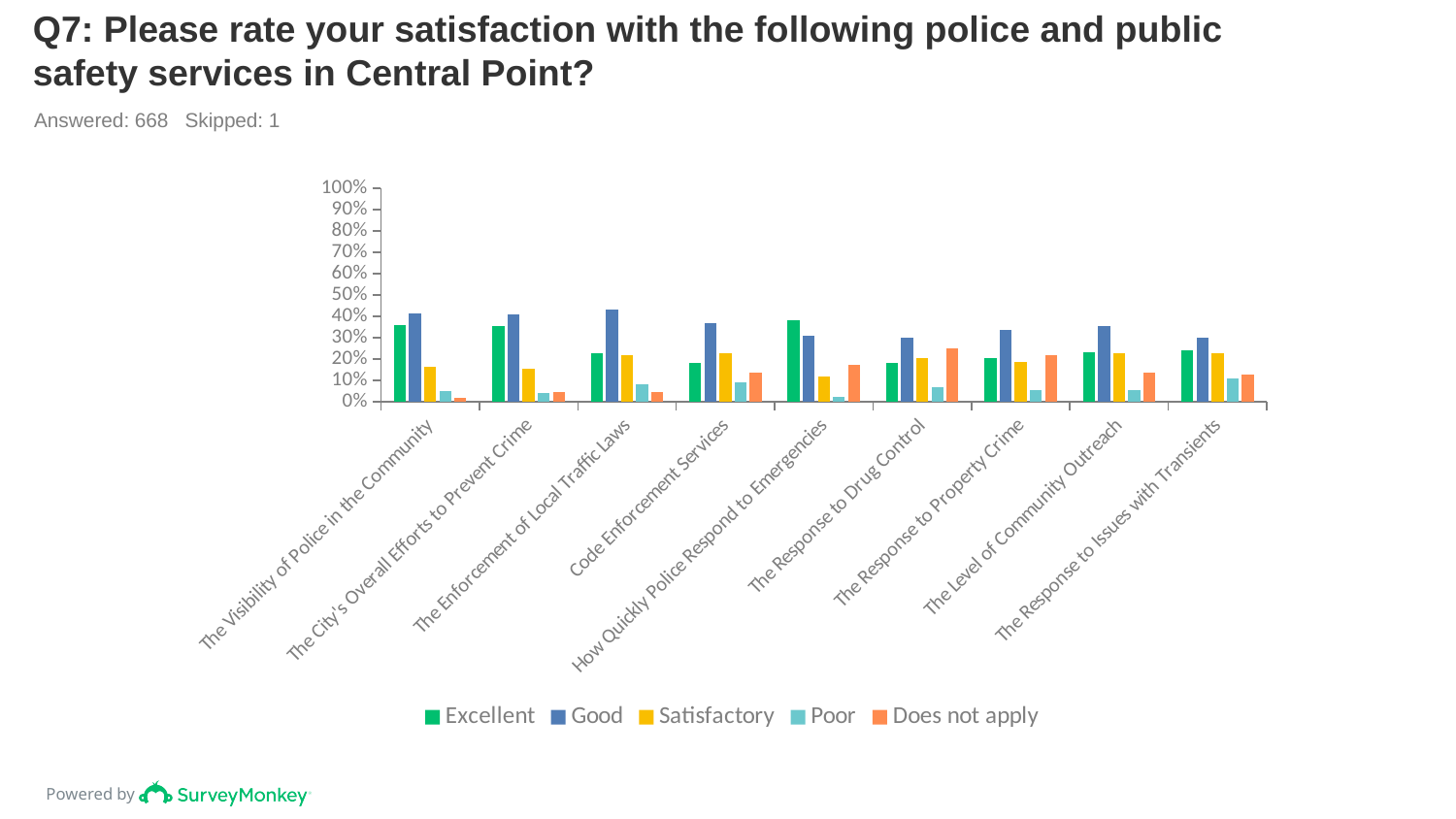
How many series does the legend list? 5 What kind of chart is shown on the slide? bar chart Is the Good value for The Response to Drug Control greater or less than 20%? greater Which is larger: the Excellent value for The Visibility of Police in the Community or the Excellent value for Code Enforcement Services? The Visibility of Police in the Community Which category has the lowest Does not apply value? The Visibility of Police in the Community Is the Good value for The Enforcement of Local Traffic Laws greater or less than 40%? greater For Code Enforcement Services, which is larger: the Poor value or the Does not apply value? Does not apply Is the Excellent value for Code Enforcement Services greater or less than 30%? less How many service categories are shown on the x axis? 9 For How Quickly Police Respond to Emergencies, which is larger: the Excellent value or the Good value? Excellent How many respondents answered this question according to the slide? 668